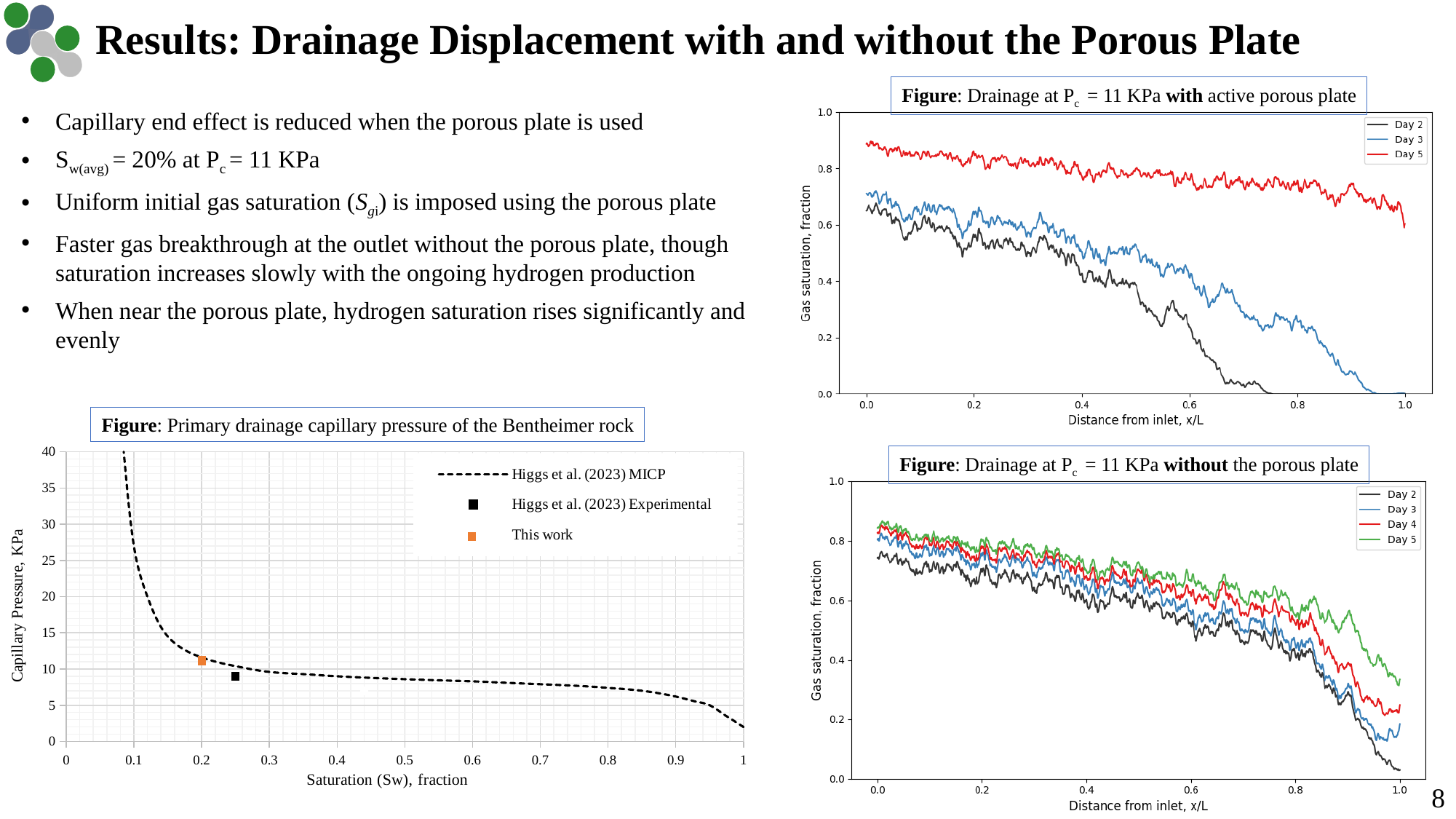
In the chart titled 'Drainage at Pc = 11 KPa without the porous plate', which series has the lowest gas saturation across the plot? Day 2 In the chart titled 'Drainage at Pc = 11 KPa without the porous plate', is the Day 5 gas saturation at x/L = 1.0 greater or less than 0.2? greater In the chart titled 'Drainage at Pc = 11 KPa with active porous plate', which series has the highest gas saturation across the plot? Day 5 In the chart titled 'Drainage at Pc = 11 KPa with active porous plate', does the Day 5 gas saturation rise or fall as distance from inlet increases? fall In the chart titled 'Drainage at Pc = 11 KPa without the porous plate', how many series does the legend list? 4 What is the x-axis label of the 'Primary drainage capillary pressure of the Bentheimer rock' chart? Saturation (Sw), fraction In the chart titled 'Drainage at Pc = 11 KPa with active porous plate', how many series does the legend list? 3 In the chart titled 'Drainage at Pc = 11 KPa with active porous plate', is the Day 2 gas saturation at x/L = 0.8 greater or less than 0.2? less In the chart titled 'Drainage at Pc = 11 KPa with active porous plate', is the Day 5 gas saturation at x/L = 0.2 greater or less than 0.8? greater What kind of chart is the 'Primary drainage capillary pressure of the Bentheimer rock' figure? line chart In the chart titled 'Drainage at Pc = 11 KPa without the porous plate', at x/L = 0.9, which series has the larger gas saturation, Day 5 or Day 2? Day 5